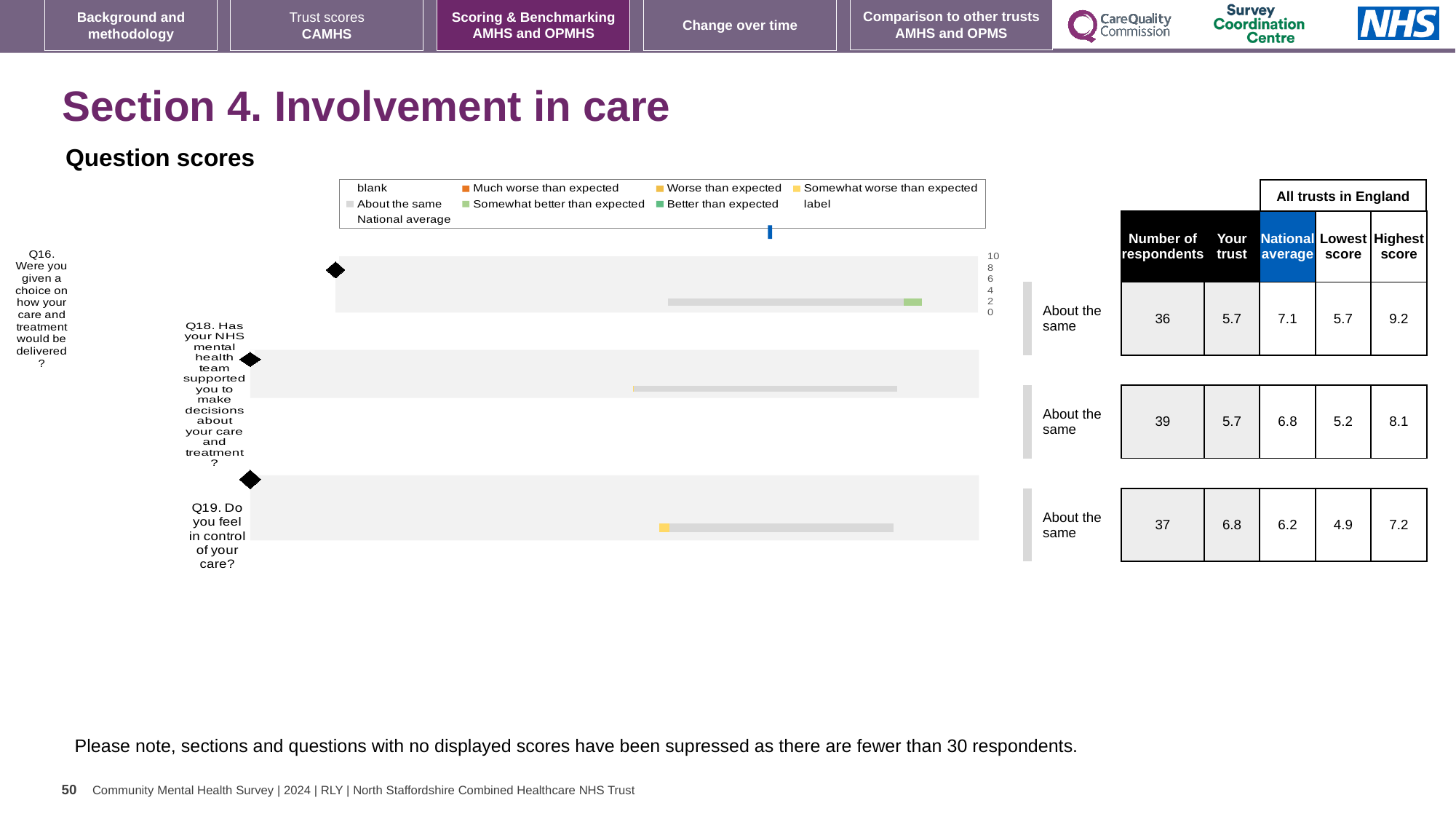
How many entries does the legend above the question scores charts list? 9 For Q19, which is larger: the 'Your trust' score or the national average? Your trust How many questions (Q16, Q18, Q19) are plotted in the question scores charts? 3 What is the national average score for Q18 (Has your NHS mental health team supported you to make decisions about your care and treatment?)? 6.8 How many respondents answered Q19 (Do you feel in control of your care?)? 37 Which question has the lowest 'Lowest score' across all trusts in England? Q19 What is the 'Your trust' score for Q16 (Were you given a choice on how your care and treatment would be delivered?)? 5.7 What kind of chart is used to show the question scores on this slide? bar chart What benchmark label is shown for Q18 (Has your NHS mental health team supported you to make decisions about your care and treatment?)? About the same What is the difference between the national average and the 'Your trust' score for Q16? 1.4 What is the highest score across all trusts in England for Q16? 9.2 Which question has the largest number of respondents? Q18